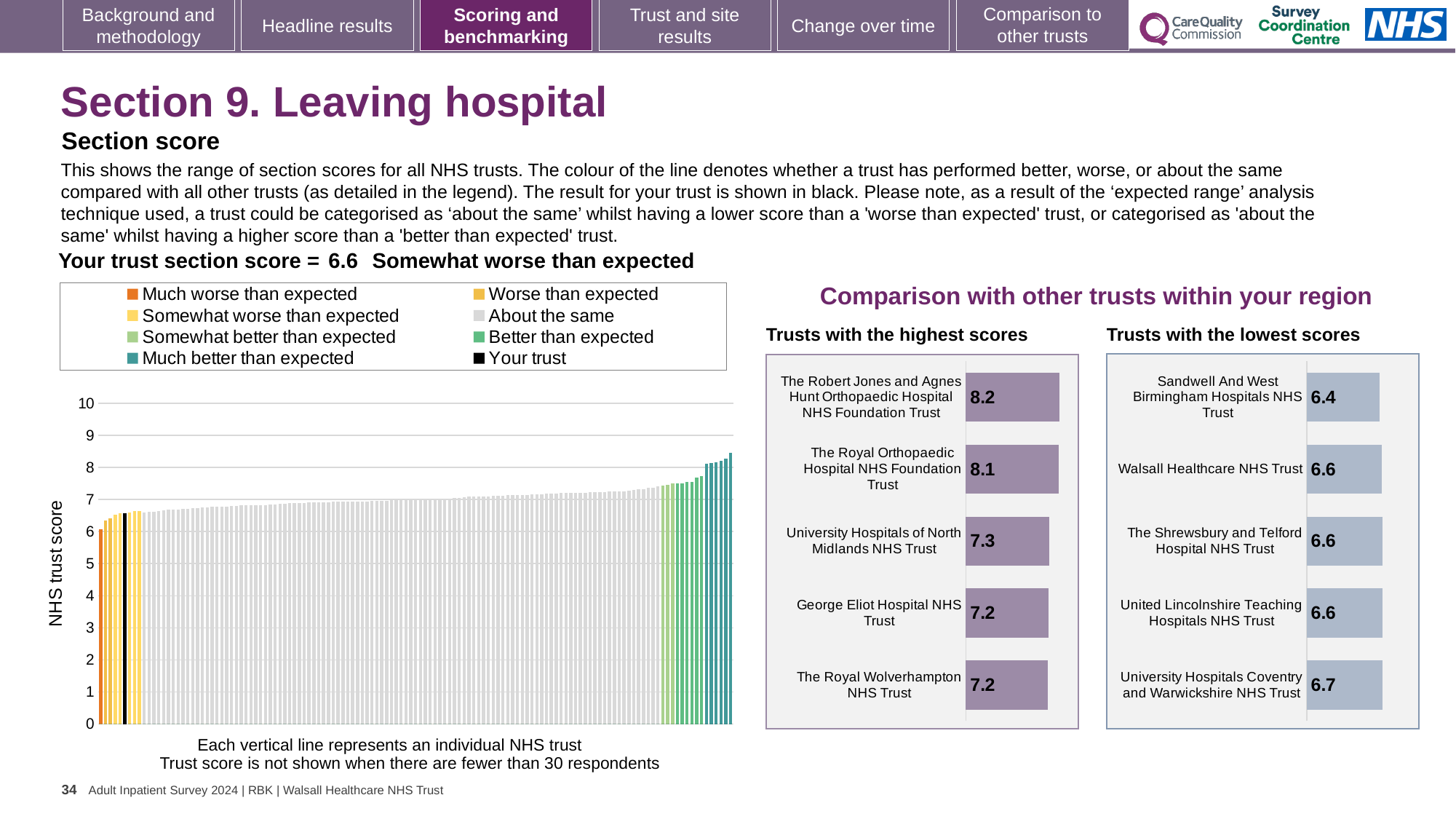
In the 'Trusts with the highest scores' chart, what is the difference between the scores of The Royal Orthopaedic Hospital NHS Foundation Trust and University Hospitals of North Midlands NHS Trust? 0.8 In the NHS trust score chart on the left, is the value of the tallest bar greater or less than 8? greater In the 'Trusts with the lowest scores' chart, what is the score for Walsall Healthcare NHS Trust? 6.6 In the 'Trusts with the lowest scores' chart, which trust has the lowest score? Sandwell And West Birmingham Hospitals NHS Trust In the 'Trusts with the highest scores' chart, what is the score for The Robert Jones and Agnes Hunt Orthopaedic Hospital NHS Foundation Trust? 8.2 In the 'Trusts with the highest scores' chart, which trust has the highest score? The Robert Jones and Agnes Hunt Orthopaedic Hospital NHS Foundation Trust In the 'Trusts with the lowest scores' chart, what is the score for Sandwell And West Birmingham Hospitals NHS Trust? 6.4 What kind of chart is the NHS trust score chart on the left of the slide? Bar chart How many entries does the legend of the NHS trust score chart on the left list? 8 How many trusts are shown in the 'Trusts with the highest scores' chart? 5 In the 'Trusts with the lowest scores' chart, which has the larger score: University Hospitals Coventry and Warwickshire NHS Trust or Sandwell And West Birmingham Hospitals NHS Trust? University Hospitals Coventry and Warwickshire NHS Trust In the NHS trust score chart on the left, do the values rise or fall from left to right? Rise